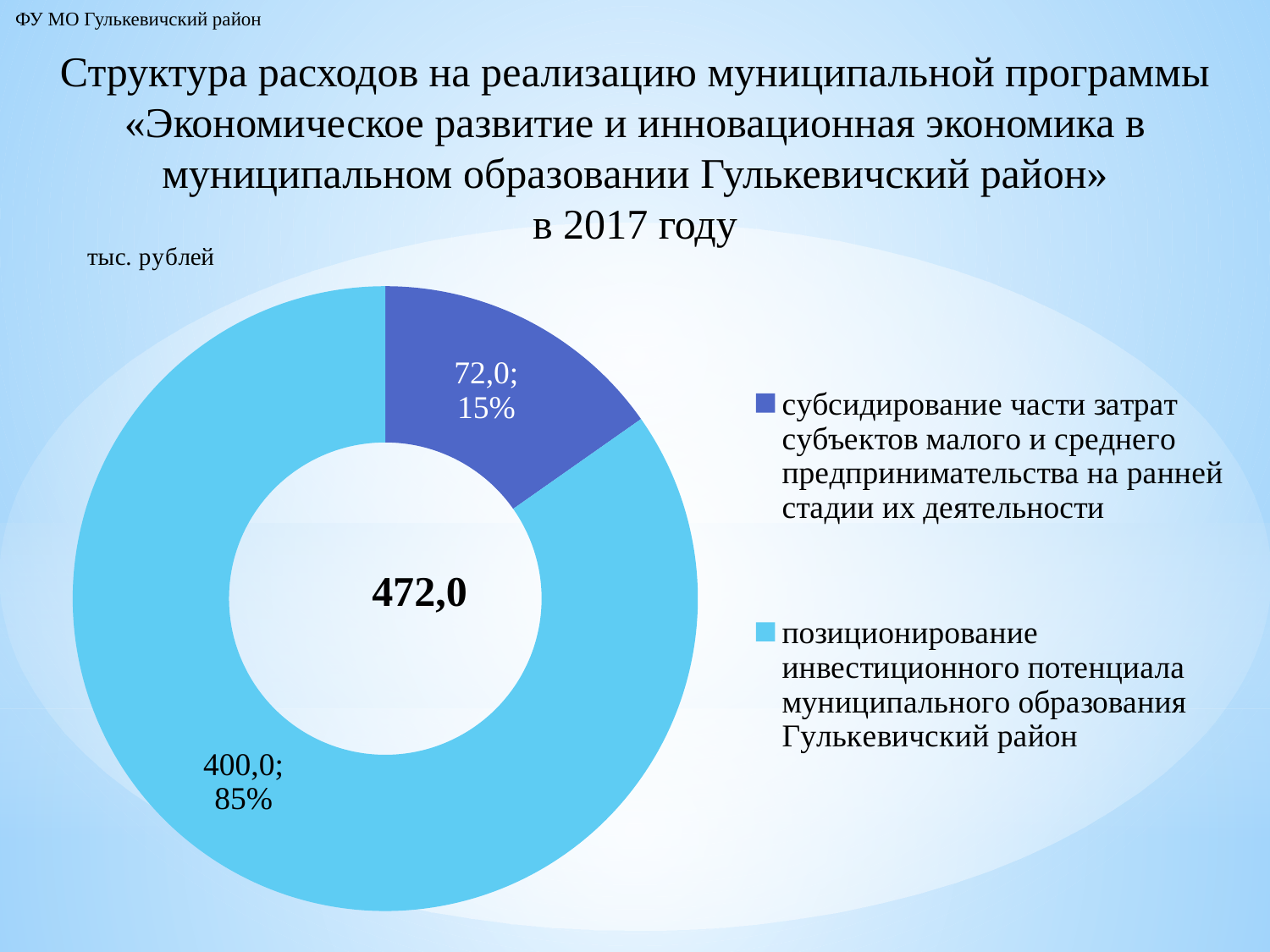
Какая доля расходов приходится на субсидирование части затрат субъектов малого и среднего предпринимательства? 15% Какое значение (тыс. рублей) приходится на субсидирование части затрат субъектов малого и среднего предпринимательства на ранней стадии их деятельности? 72,0 Какой тип диаграммы показан на слайде? кольцевая диаграмма Какая доля расходов приходится на позиционирование инвестиционного потенциала муниципального образования? 85% Какое направление расходов имеет наименьшее значение? субсидирование части затрат субъектов малого и среднего предпринимательства на ранней стадии их деятельности В каких единицах измерения приведены значения на диаграмме? тыс. рублей Какое значение (тыс. рублей) приходится на позиционирование инвестиционного потенциала муниципального образования Гулькевичский район? 400,0 Что больше: расходы на субсидирование части затрат субъектов малого и среднего предпринимательства или на позиционирование инвестиционного потенциала? позиционирование инвестиционного потенциала Какова общая сумма расходов, указанная в центре диаграммы? 472,0 Сколько категорий (секторов) показано на диаграмме? 2 Какое направление расходов имеет наибольшее значение? позиционирование инвестиционного потенциала муниципального образования Гулькевичский район На сколько тыс. рублей расходы на позиционирование инвестиционного потенциала больше расходов на субсидирование части затрат субъектов малого и среднего предпринимательства? 328,0